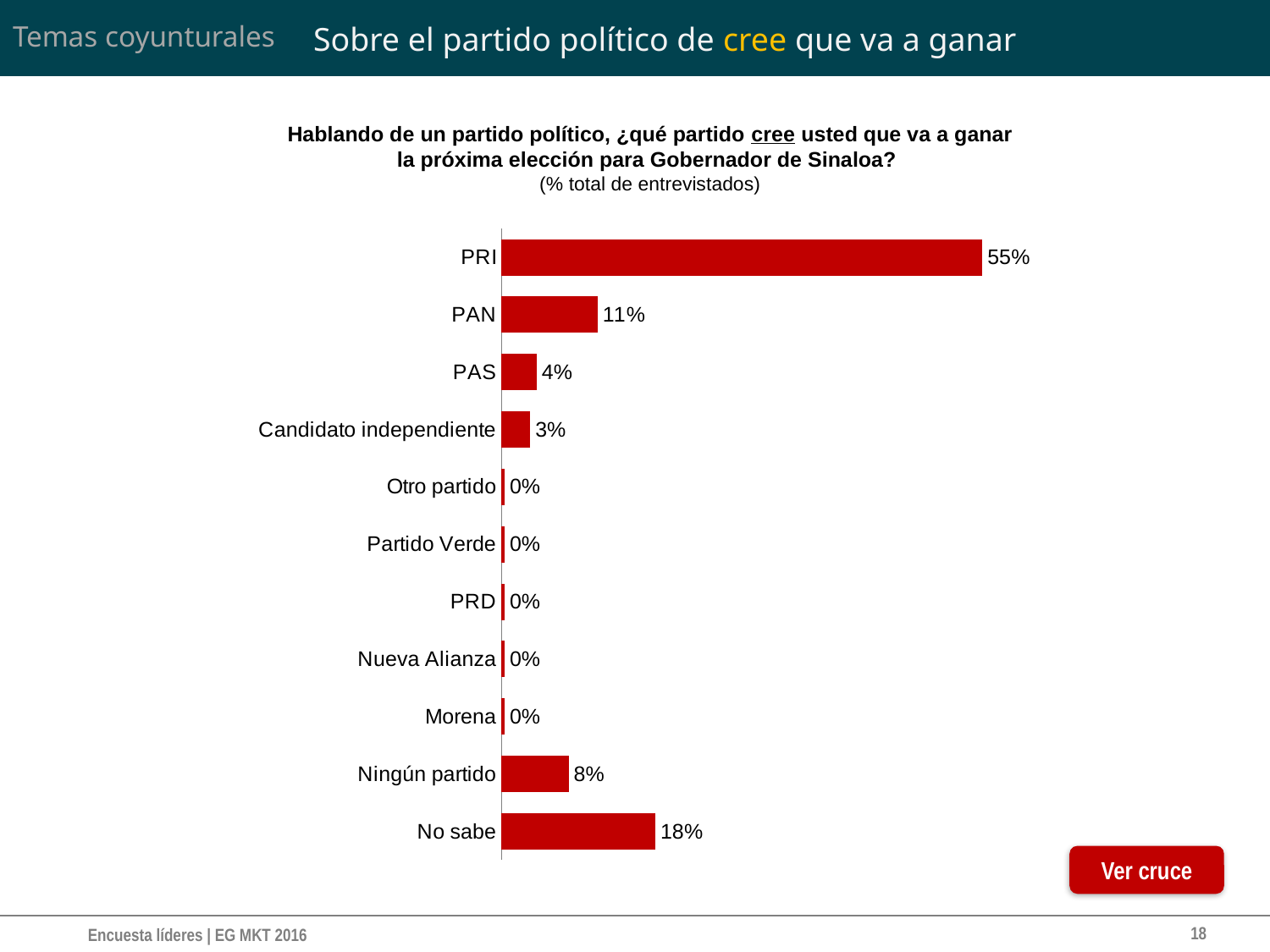
What is the difference between the values for 'No sabe' and 'Ningún partido'? 10% What percentage is shown for 'No sabe'? 18% Which party or option has the highest percentage in the chart? PRI Which has a larger value, PAS or PAN? PAN What is the value for 'Ningún partido'? 8% How many categories show a value of 0%? 5 What type of chart is shown on the slide? Bar chart What is the difference between the percentages for PRI and PAN? 44% What is the value shown for PAN? 11% What percentage is shown for 'Candidato independiente'? 3% What percentage of respondents believe PRI will win the next election for Governor of Sinaloa? 55% How many categories are shown in the chart? 11